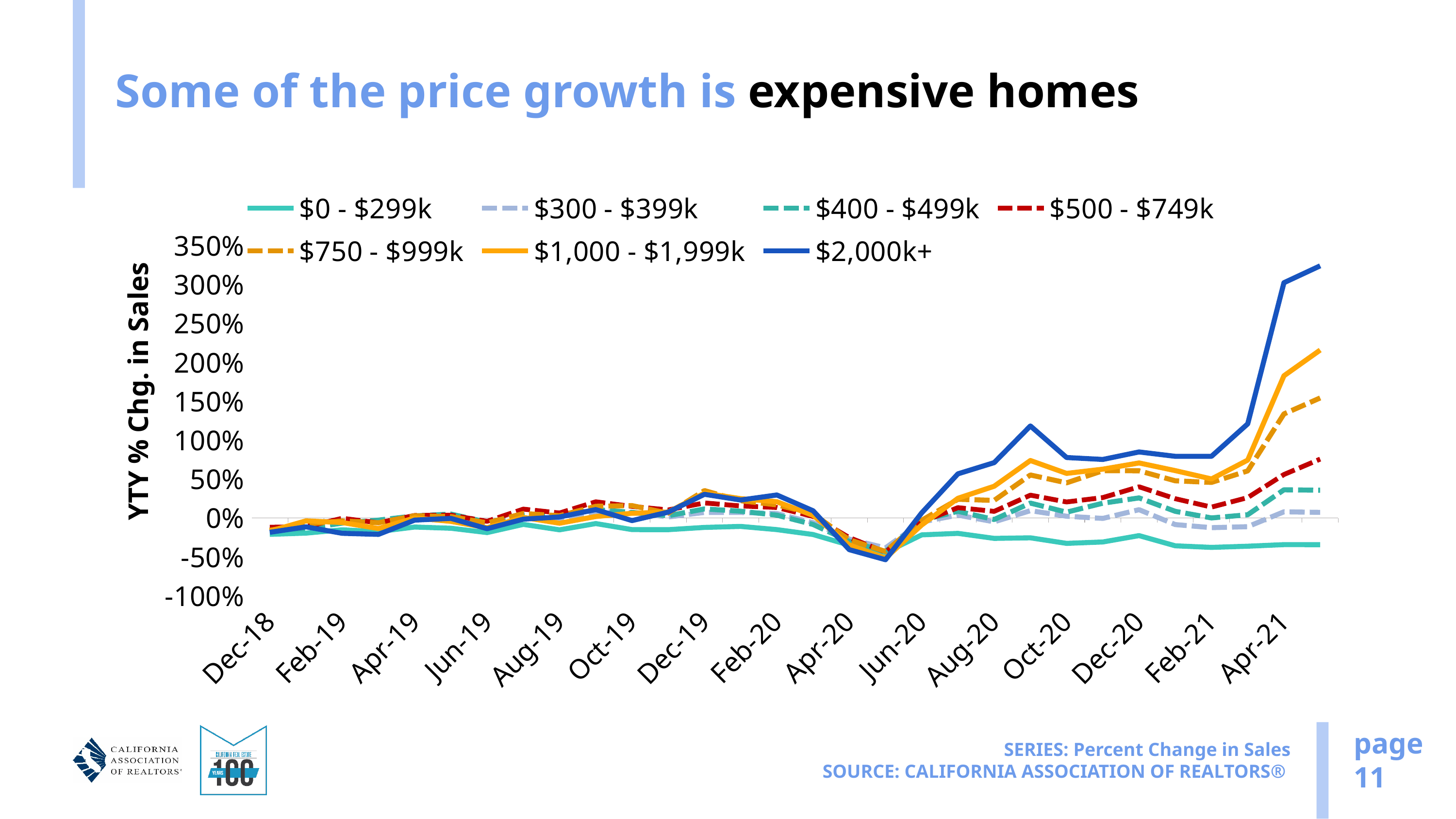
Is the value for $0 - $299k at the final point of the chart greater or less than 0%? less Is the value for $2,000k+ at the final point of the chart greater or less than 300%? greater What kind of chart is shown on the slide? line chart Is the value for $1,000 - $1,999k at the final point of the chart greater or less than 200%? greater Does the $2,000k+ series rise or fall from Jun-20 to the end of the chart? rise How many series does the legend list? 7 At the final point of the chart, which is larger: $2,000k+ or $500 - $749k? $2,000k+ Which price range series is highest at the right end of the chart (Apr-21 and after)? $2,000k+ What is the y-axis title of the chart? YTY % Chg. in Sales How many month labels are shown on the x axis? 15 Which price range series is lowest at the right end of the chart (Apr-21 and after)? $0 - $299k